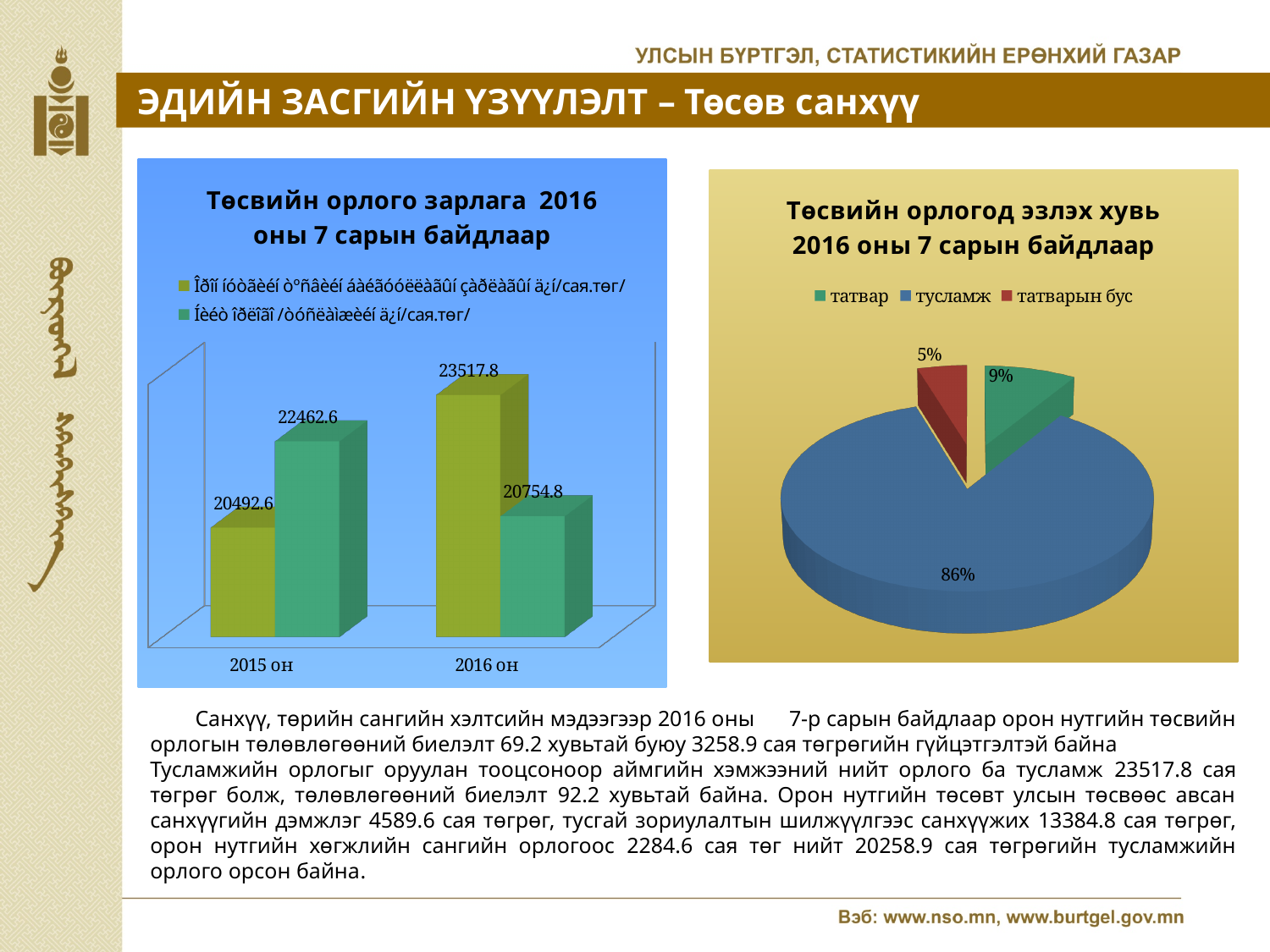
In the left bar chart, which is larger for 2015 он: the olive bar or the green bar? The green bar (22462.6) How many categories are shown on the x axis of the left bar chart? 2 How many series does the legend of the right pie chart list? 3 What kind of chart is the right chart titled "Төсвийн орлогод эзлэх хувь 2016 оны 7 сарын байдлаар"? Pie chart In the right pie chart, what share does тусламж have? 86% In the left bar chart, what is the difference between the olive bar for 2016 он and the olive bar for 2015 он? 3025.2 In the left bar chart, which bar has the highest value? The olive bar for 2016 он (23517.8) In the left bar chart, what is the value of the olive (first) bar for 2016 он? 23517.8 In the left bar chart, what is the value of the green (second) bar for 2016 он? 20754.8 What kind of chart is the left chart titled "Төсвийн орлого зарлага 2016 оны 7 сарын байдлаар"? Bar chart In the right pie chart, which category has the smallest share? татварын бус In the left bar chart, what is the value of the olive (first) bar for 2015 он? 20492.6